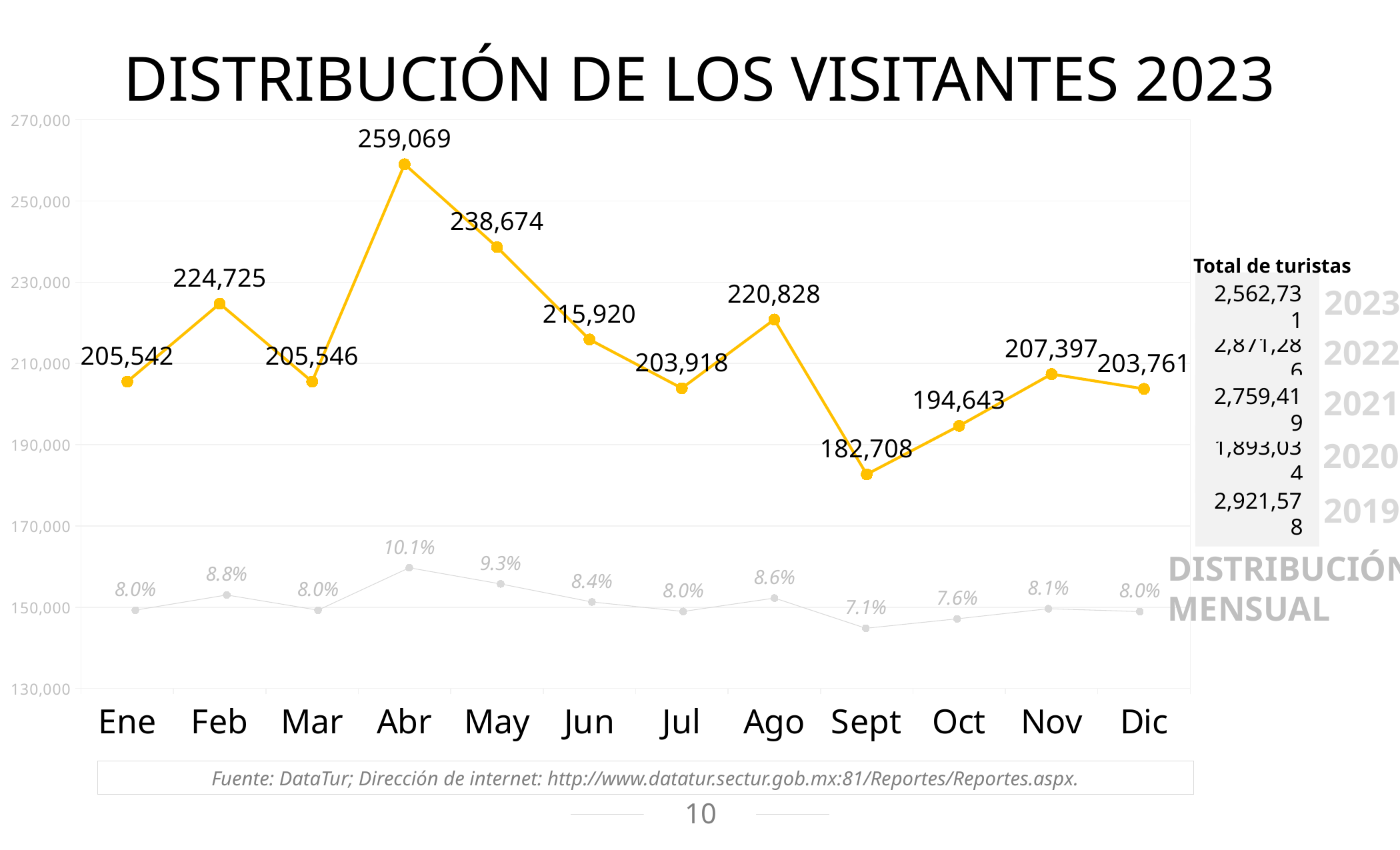
What type of chart is shown on the slide? line chart What is the number of visitors for Nov? 207,397 How many months are plotted along the x axis? 12 Which month has the lowest number of visitors? Sept What is the number of visitors for Sept? 182,708 Do the visitor values rise or fall from Abr to Jul? fall What is the difference between the visitors in Feb and in Ene? 19,183 What is the number of visitors for Abr? 259,069 Is the value for Jul greater or less than 210,000? less Which month has more visitors, Feb or Ago? Feb Which month has the highest number of visitors? Abr What is the difference between the visitors in Abr and in Sept? 76,361